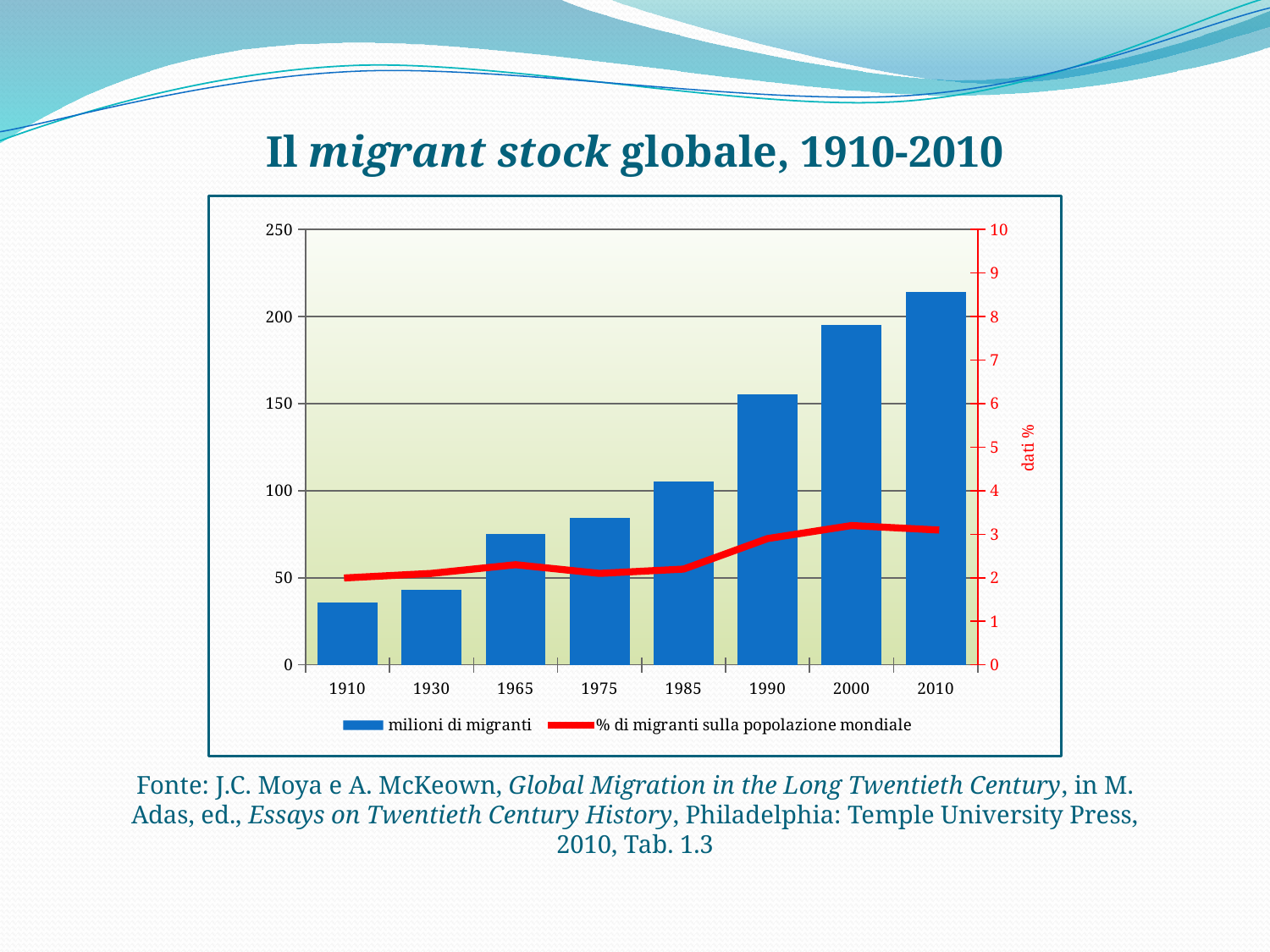
Is the 'milioni di migranti' bar for 2010 greater or less than 200? greater Which year has the larger 'milioni di migranti' bar, 1985 or 2000? 2000 Is the '% di migranti sulla popolazione mondiale' value for 1910 greater or less than 3? less Is the 'milioni di migranti' bar for 1990 greater or less than 150? greater Do the 'milioni di migranti' bars generally rise or fall from 1910 to 2010? rise How many series does the chart legend list? 2 What kind of chart is shown on the slide? Bar chart with a line overlay Which year has the highest bar for 'milioni di migranti'? 2010 How many categories (years) are shown on the x axis of the chart? 8 Which year has the lowest bar for 'milioni di migranti'? 1910